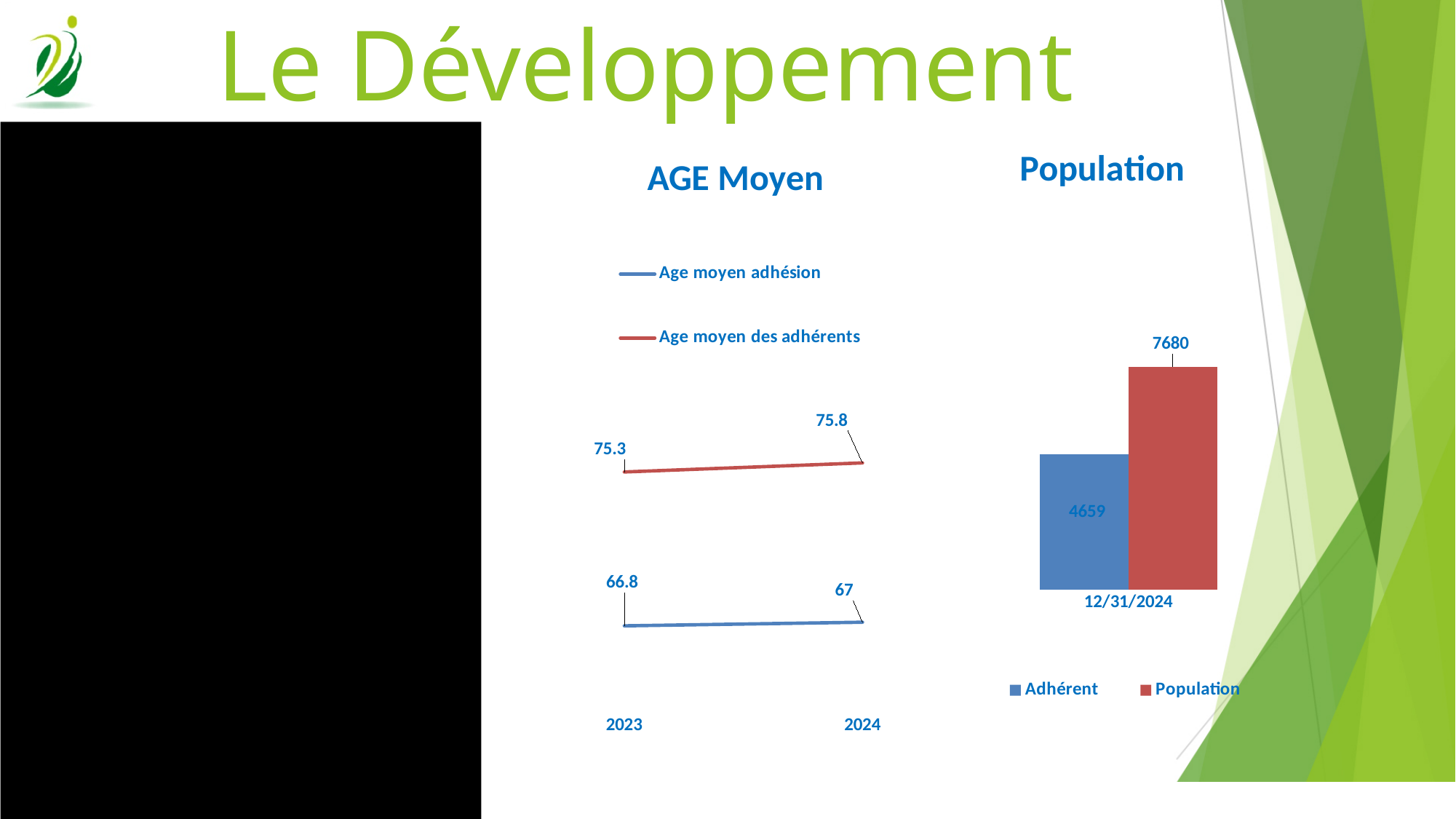
In the 'AGE Moyen' chart, what is the value of 'Age moyen des adhérents' in 2023? 75.3 In the 'AGE Moyen' chart, what is the value of 'Age moyen adhésion' in 2024? 67 In the 'AGE Moyen' chart, what is the value of 'Age moyen adhésion' in 2023? 66.8 In the 'Population' chart, what is the value for 'Adhérent'? 4659 In the 'Population' chart, what is the difference between 'Population' and 'Adhérent'? 3021 In the 'Population' chart, what is the value for 'Population'? 7680 In the 'AGE Moyen' chart, what is the value of 'Age moyen des adhérents' in 2024? 75.8 In the 'AGE Moyen' chart, how many series does the legend list? 2 In the 'AGE Moyen' chart, what is the difference between 'Age moyen des adhérents' and 'Age moyen adhésion' in 2024? 8.8 What kind of chart is the 'Population' chart? bar chart What kind of chart is the 'AGE Moyen' chart? line chart In the 'AGE Moyen' chart, does 'Age moyen des adhérents' rise or fall from 2023 to 2024? rise